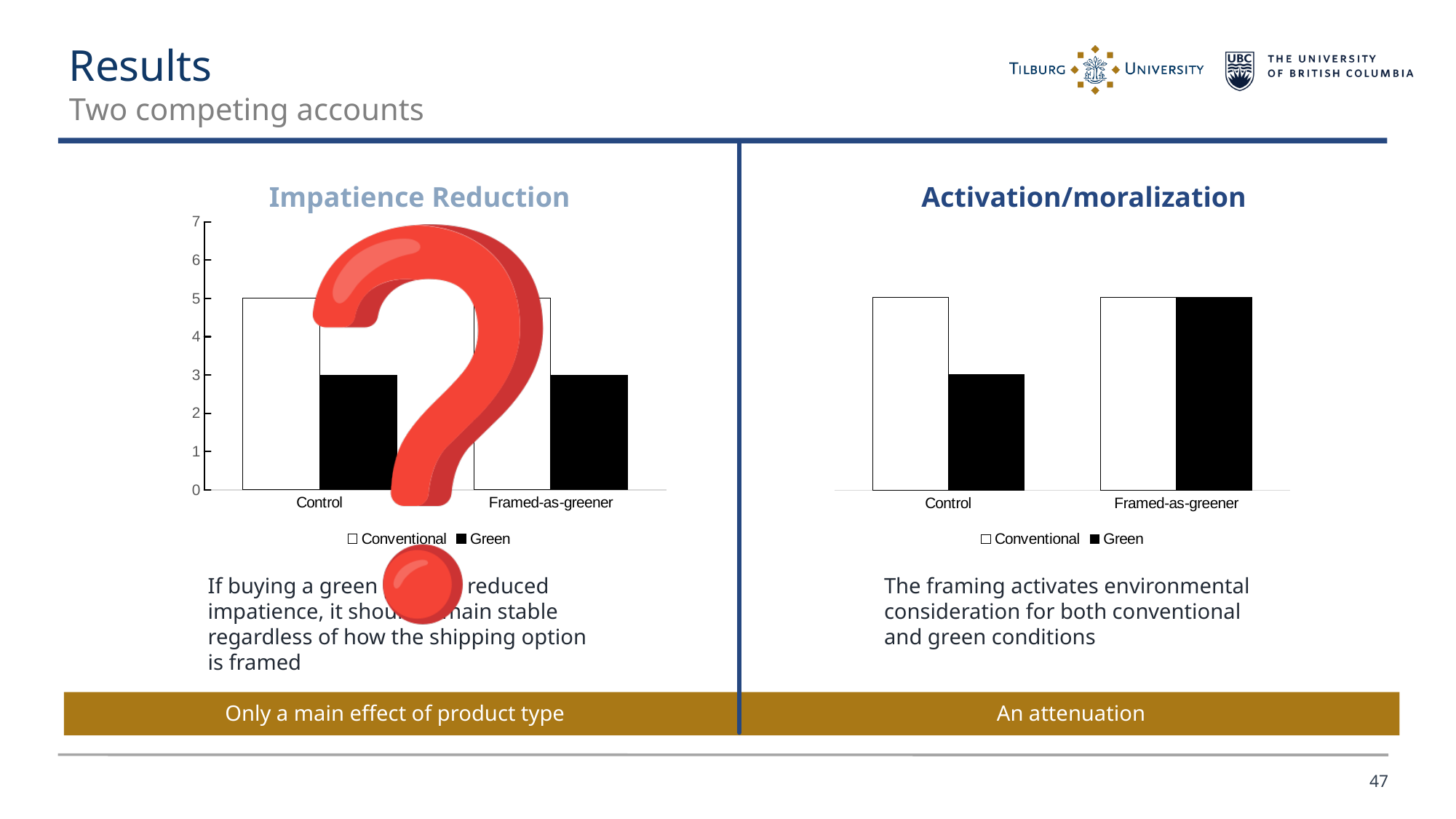
In the Activation/moralization chart, which series is higher in the Control condition, Conventional or Green? Conventional How many categories are shown on the x axis of the Impatience Reduction chart? 2 What kind of chart is the Activation/moralization chart? bar chart In the Impatience Reduction chart, which series is higher in the Framed-as-greener condition, Conventional or Green? Conventional In the Impatience Reduction chart, what is the value for Conventional in the Control condition? 5 In the Impatience Reduction chart, what is the difference between the Conventional and Green values in the Control condition? 2 In the Impatience Reduction chart, what is the value for Green in the Control condition? 3 In the Activation/moralization chart, does the Green bar rise or fall from Control to Framed-as-greener? rise In the Impatience Reduction chart, which colour represents the Green series? black How many series does the legend of the Activation/moralization chart list? 2 In the Impatience Reduction chart, what is the value for Green in the Framed-as-greener condition? 3 In the Impatience Reduction chart, is the Green value in the Framed-as-greener condition greater or less than 4? less